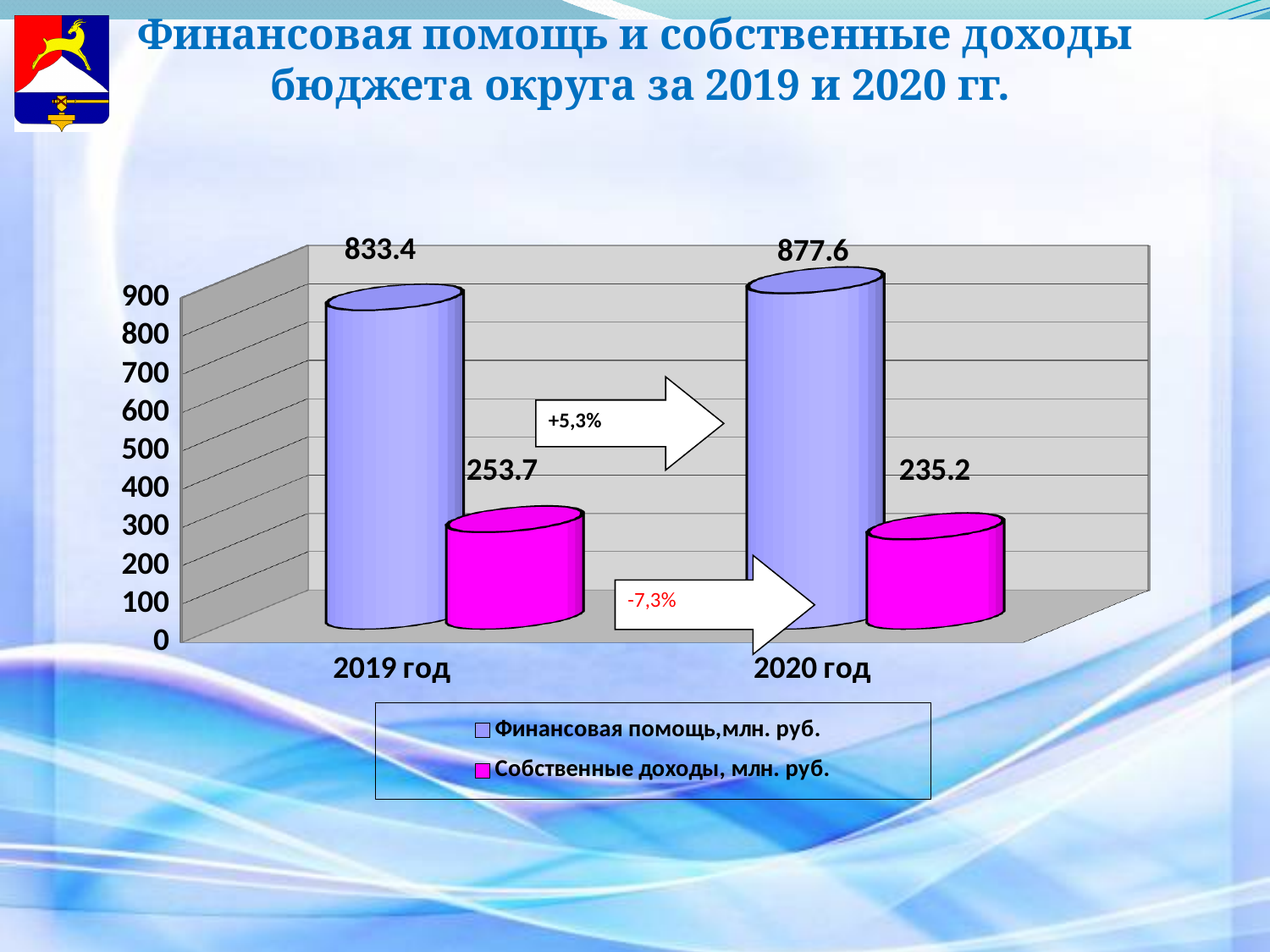
What kind of chart is shown on the slide? Bar chart How many categories are shown on the x axis? 2 Which is larger: Собственные доходы in 2019 год or in 2020 год? 2019 год How many series does the legend list? 2 Which year has the higher value for Финансовая помощь? 2020 год What is the difference between Финансовая помощь in 2020 год and in 2019 год? 44.2 What is the value of Финансовая помощь for 2019 год? 833.4 What is the value of Финансовая помощь for 2020 год? 877.6 Which year has the lower value for Собственные доходы? 2020 год What is the value of Собственные доходы for 2020 год? 235.2 What is the value of Собственные доходы for 2019 год? 253.7 What percentage change is shown by the arrow between the Финансовая помощь bars? +5,3%